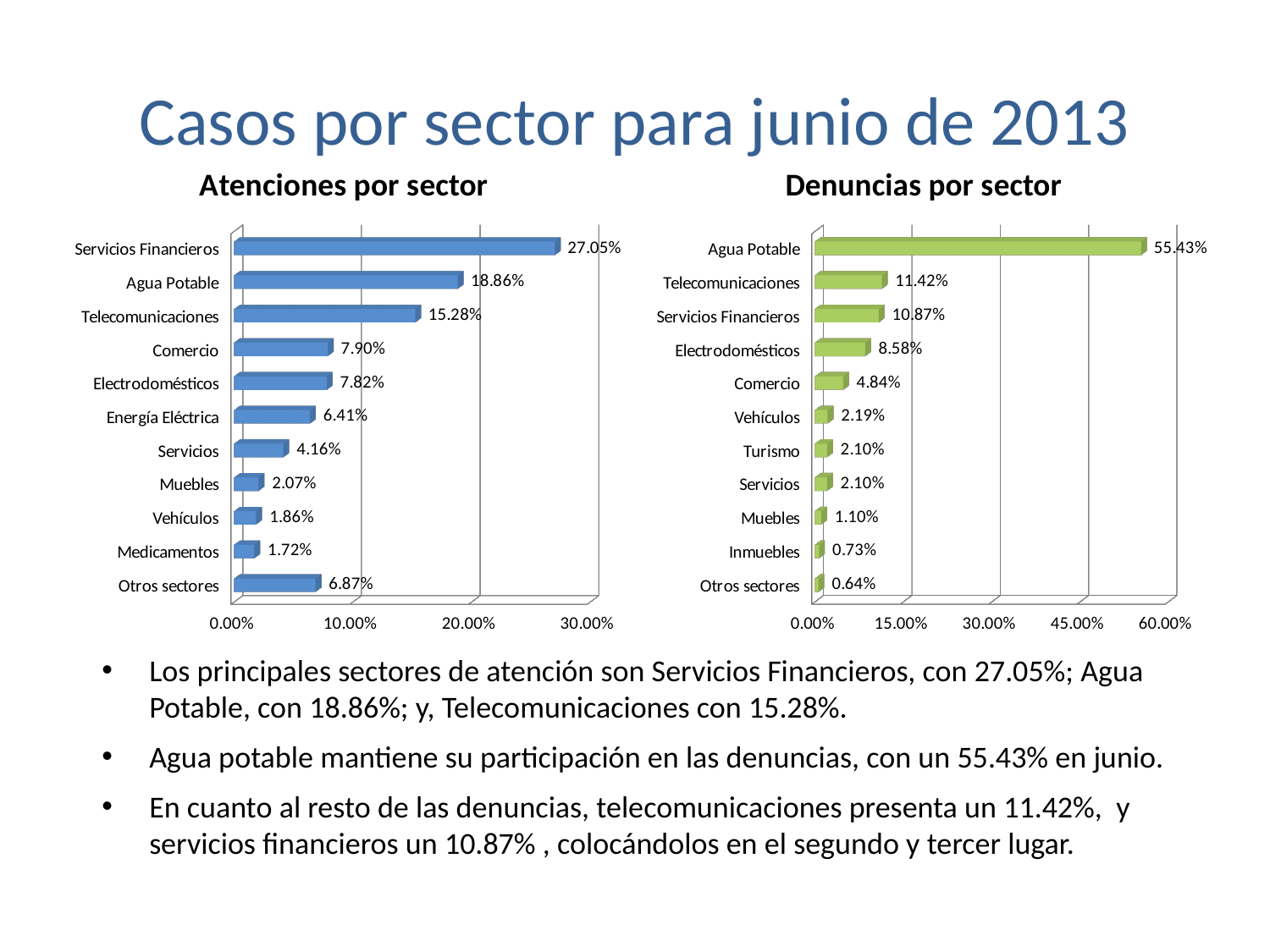
In the 'Denuncias por sector' chart, what is the value for Agua Potable? 55.43% In the 'Atenciones por sector' chart, which sector has the highest value? Servicios Financieros In the 'Denuncias por sector' chart, what is the difference between Telecomunicaciones and Servicios Financieros? 0.55% How many sectors are shown in the 'Denuncias por sector' chart? 11 In the 'Atenciones por sector' chart, which is larger: Comercio or Electrodomésticos? Comercio In the 'Denuncias por sector' chart, what is the value for Electrodomésticos? 8.58% In the 'Atenciones por sector' chart, what is the value for Energía Eléctrica? 6.41% In the 'Atenciones por sector' chart, what is the value for Servicios Financieros? 27.05% In the 'Atenciones por sector' chart, what is the difference between Agua Potable and Telecomunicaciones? 3.58% In the 'Denuncias por sector' chart, which sector has the lowest value? Otros sectores What kind of chart is 'Atenciones por sector'? Bar chart What colour are the bars in the 'Denuncias por sector' chart? Green